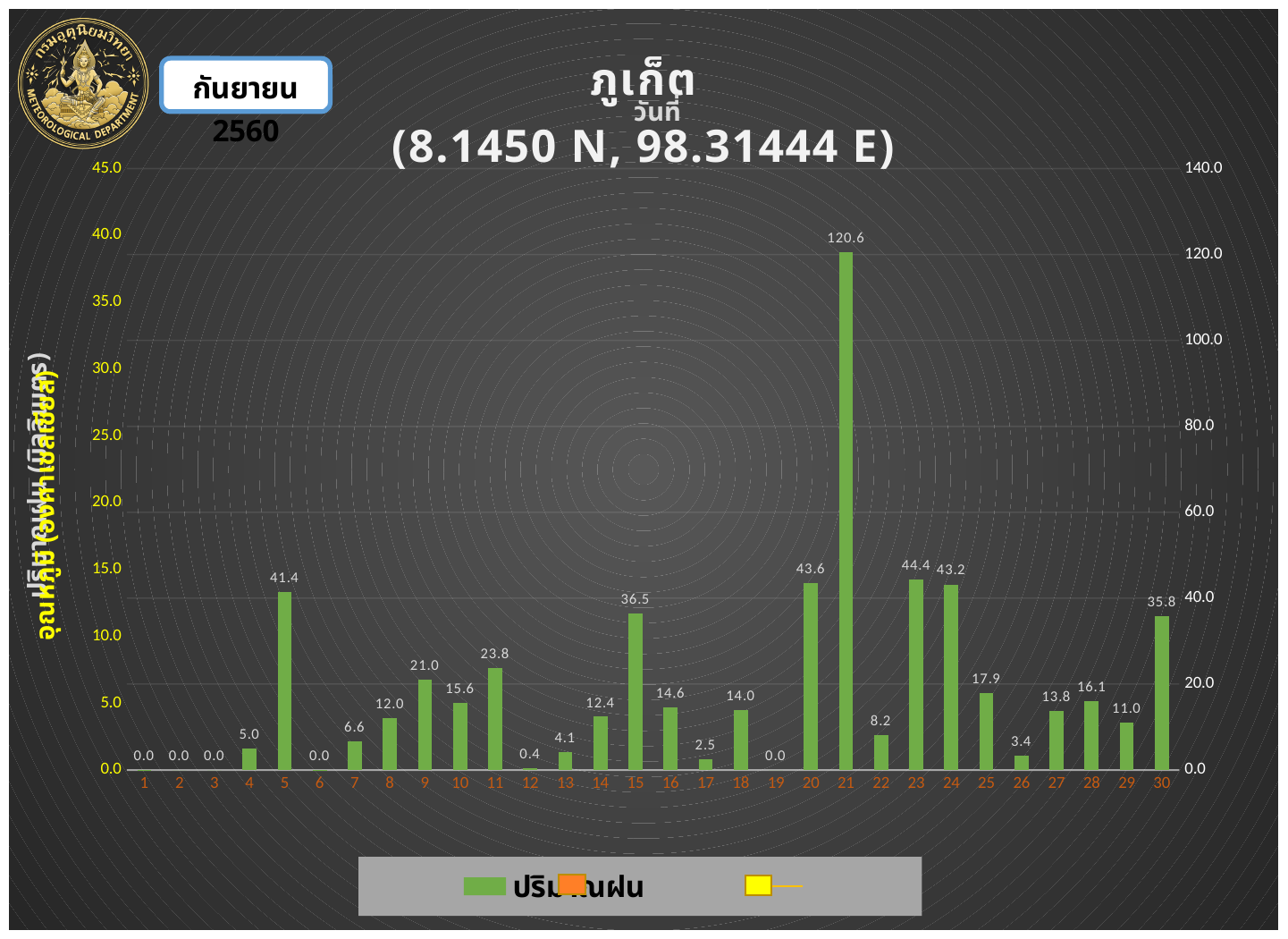
How many days (categories) are shown on the x axis? 30 What coordinates are given in the chart title? 8.1450 N, 98.31444 E Which day has the highest value? 21 What type of chart is shown? bar chart Which is larger, the value for day 9 or the value for day 11? day 11 What is the value shown for day 5? 41.4 Which is larger, the value for day 30 or the value for day 15? day 15 What is the difference between the values for day 23 and day 24? 1.2 What is the value shown for day 12? 0.4 What is the value shown for day 15? 36.5 What is the rainfall value shown for day 21? 120.6 What is the difference between the values for day 21 and day 20? 77.0